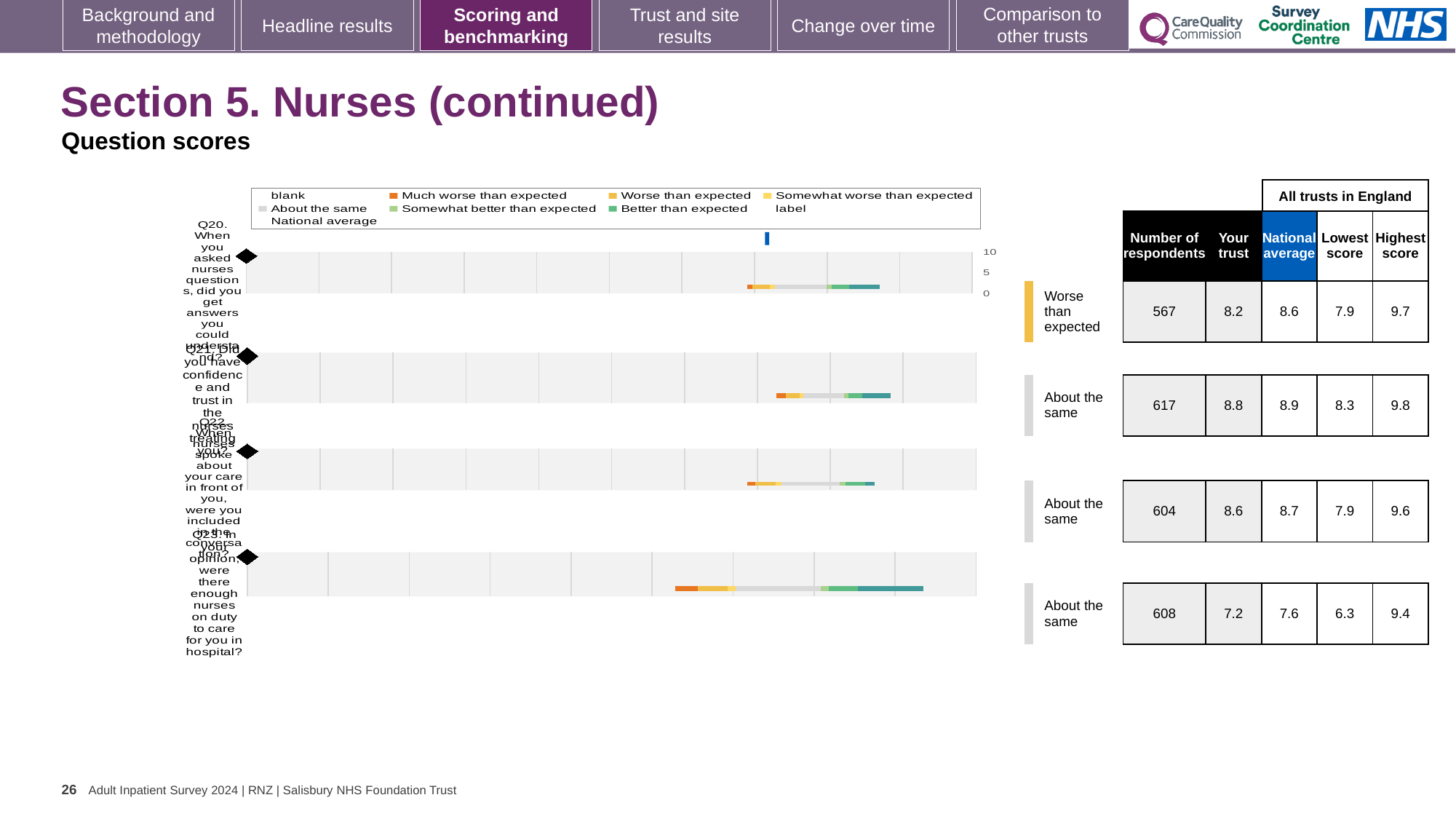
Which question has the highest 'Your trust' score? Q21 What is the lowest score among all trusts in England for Q23? 6.3 What kind of chart is used to show the question scores on this slide? bar chart What is the 'Your trust' score for Q23 (were there enough nurses on duty)? 7.2 For Q22, which is larger: the 'Your trust' score or the national average? National average What is the national average score for Q21 (confidence and trust in the nurses)? 8.9 Which question has the lowest 'Your trust' score? Q23 For Q20, how much higher is the national average than the 'Your trust' score? 0.4 What is the highest score among all trusts in England for Q21? 9.8 Which benchmark category is shown for Q20? Worse than expected How many respondents answered Q20? 567 How many questions (Q20 to Q23) are plotted in the chart? 4